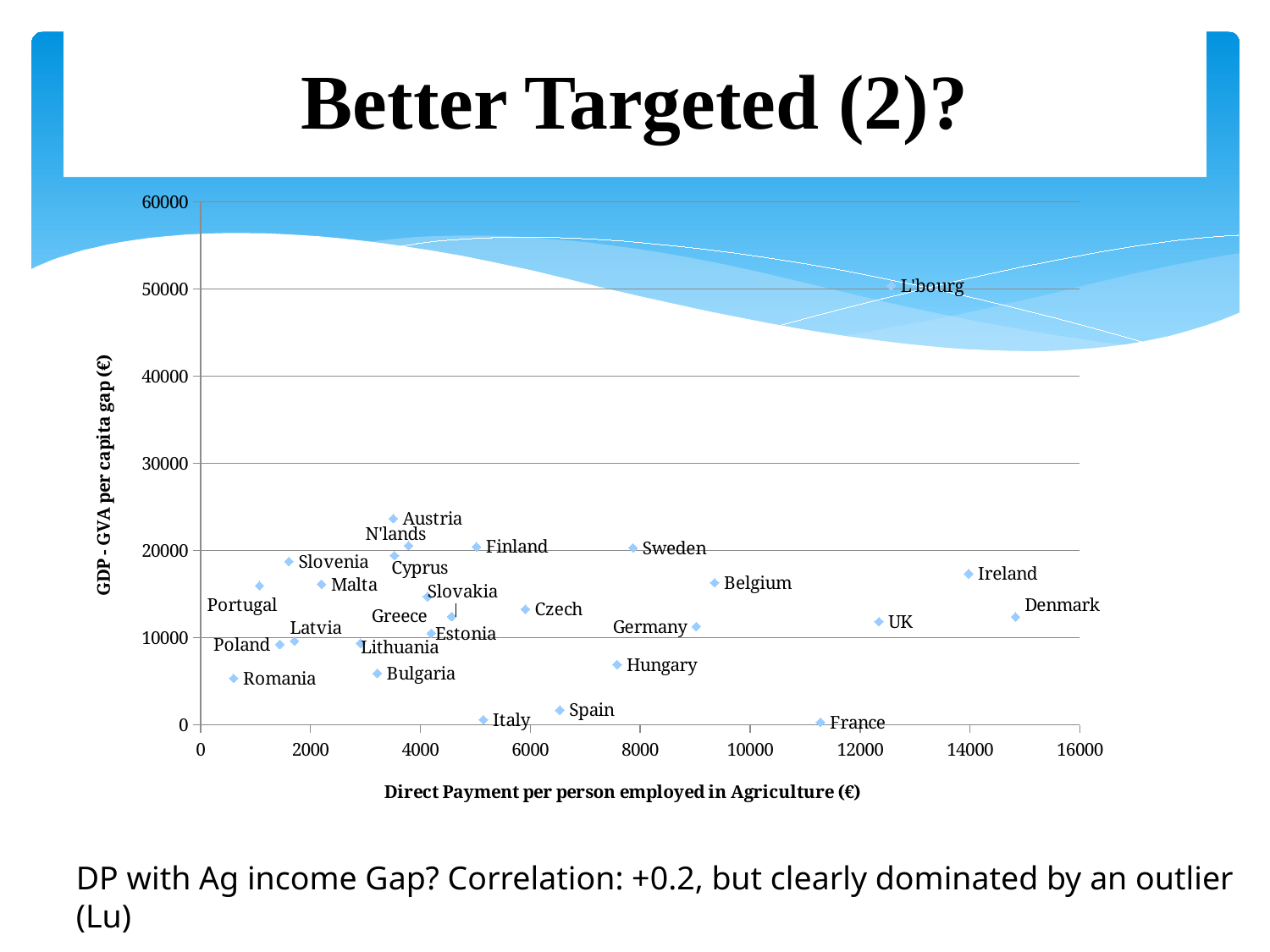
What kind of chart is shown on the slide? Scatter chart Is the GDP - GVA per capita gap for L'bourg greater or less than 40000? greater Which country has the highest Direct Payment per person employed in Agriculture? Denmark Is the GDP - GVA per capita gap for France greater or less than 10000? less Which has the larger GDP - GVA per capita gap, Ireland or Denmark? Ireland Which has the larger GDP - GVA per capita gap, Austria or Finland? Austria Is the Direct Payment per person employed in Agriculture for Ireland greater or less than 12000? greater Which country has the lowest Direct Payment per person employed in Agriculture? Romania Which country has the highest GDP - GVA per capita gap in the chart? L'bourg What is the title of the x axis of the chart? Direct Payment per person employed in Agriculture (€)